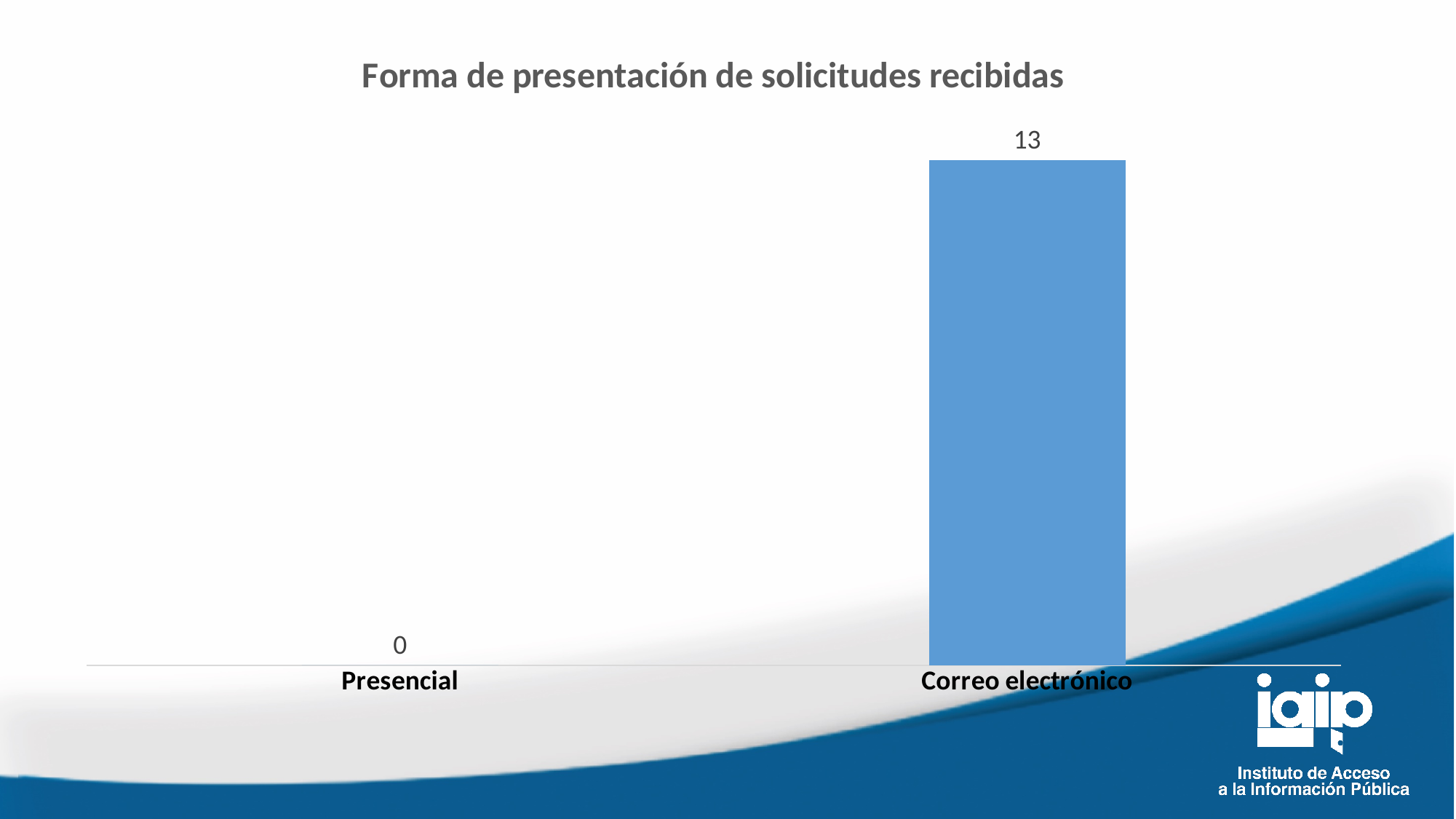
What is the title of the chart? Forma de presentación de solicitudes recibidas What kind of chart is shown on the slide? Bar chart How many categories are shown on the chart? 2 Which category has the highest value? Correo electrónico What is the value for Correo electrónico? 13 Which is larger, the value for Presencial or the value for Correo electrónico? Correo electrónico Which category has the lowest value? Presencial What is the total of the values for Presencial and Correo electrónico? 13 What is the difference between the values for Correo electrónico and Presencial? 13 What is the value for Presencial? 0 What colour is the bar for Correo electrónico? Blue